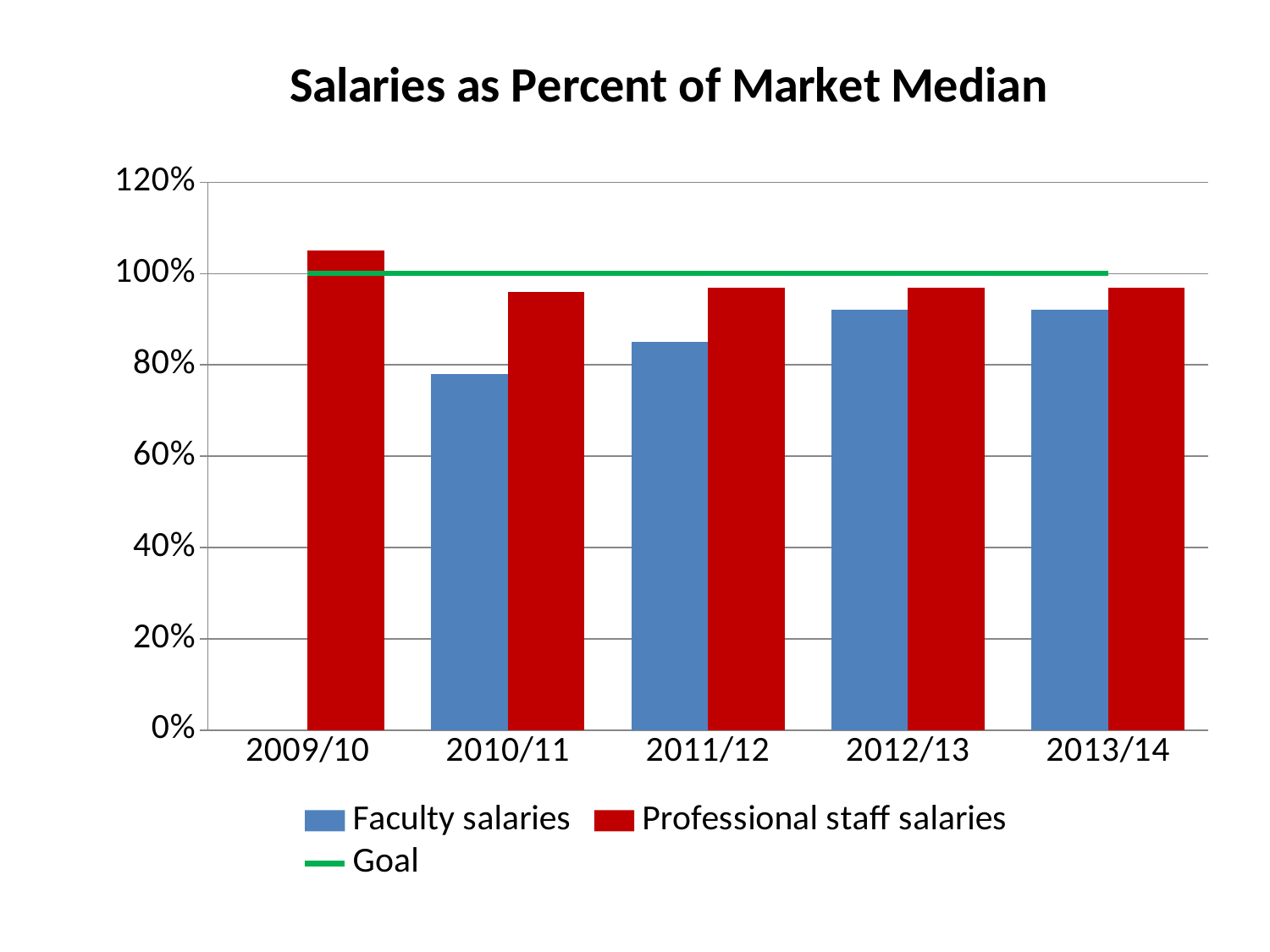
How many academic years are shown on the x axis? 5 How many series does the legend list? 3 What kind of chart is shown on the slide? bar and line chart What is the title of the chart? Salaries as Percent of Market Median In which year are Professional staff salaries highest? 2009/10 Is the value for Faculty salaries in 2010/11 greater or less than 80%? less Do Faculty salaries rise or fall from 2010/11 to 2013/14? rise Is the value for Faculty salaries in 2013/14 greater or less than 80%? greater Is the value for Professional staff salaries in 2009/10 greater or less than 100%? greater In 2011/12, which is larger: Faculty salaries or Professional staff salaries? Professional staff salaries At what level is the Goal line drawn? 100%